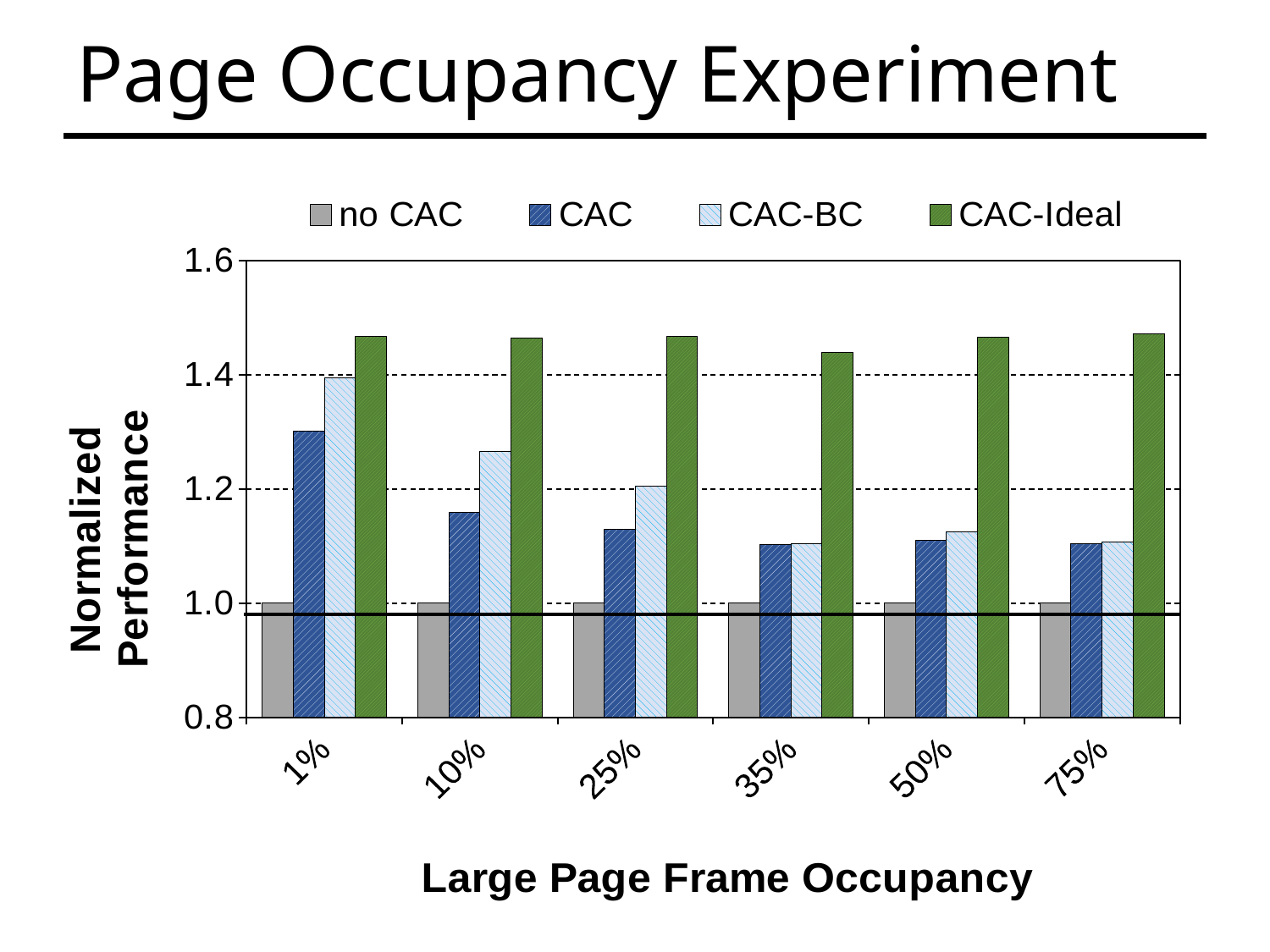
What is the title of the x axis? Large Page Frame Occupancy Is the value for CAC-BC at 1% occupancy greater or less than 1.2? greater How many series does the legend list? 4 What is the normalized performance of no CAC at 1% occupancy? 1.0 What kind of chart is shown on the slide? bar chart How many occupancy categories are shown on the x axis? 6 From 1% to 25% occupancy, do the CAC-BC values rise or fall? fall Which series has the highest value at 1% occupancy? CAC-Ideal Is the value for CAC at 10% occupancy greater or less than 1.2? less Which series has the lowest value at 25% occupancy? no CAC Is the value for CAC-Ideal at 35% occupancy greater or less than 1.4? greater At 10% occupancy, which is larger: CAC or CAC-BC? CAC-BC